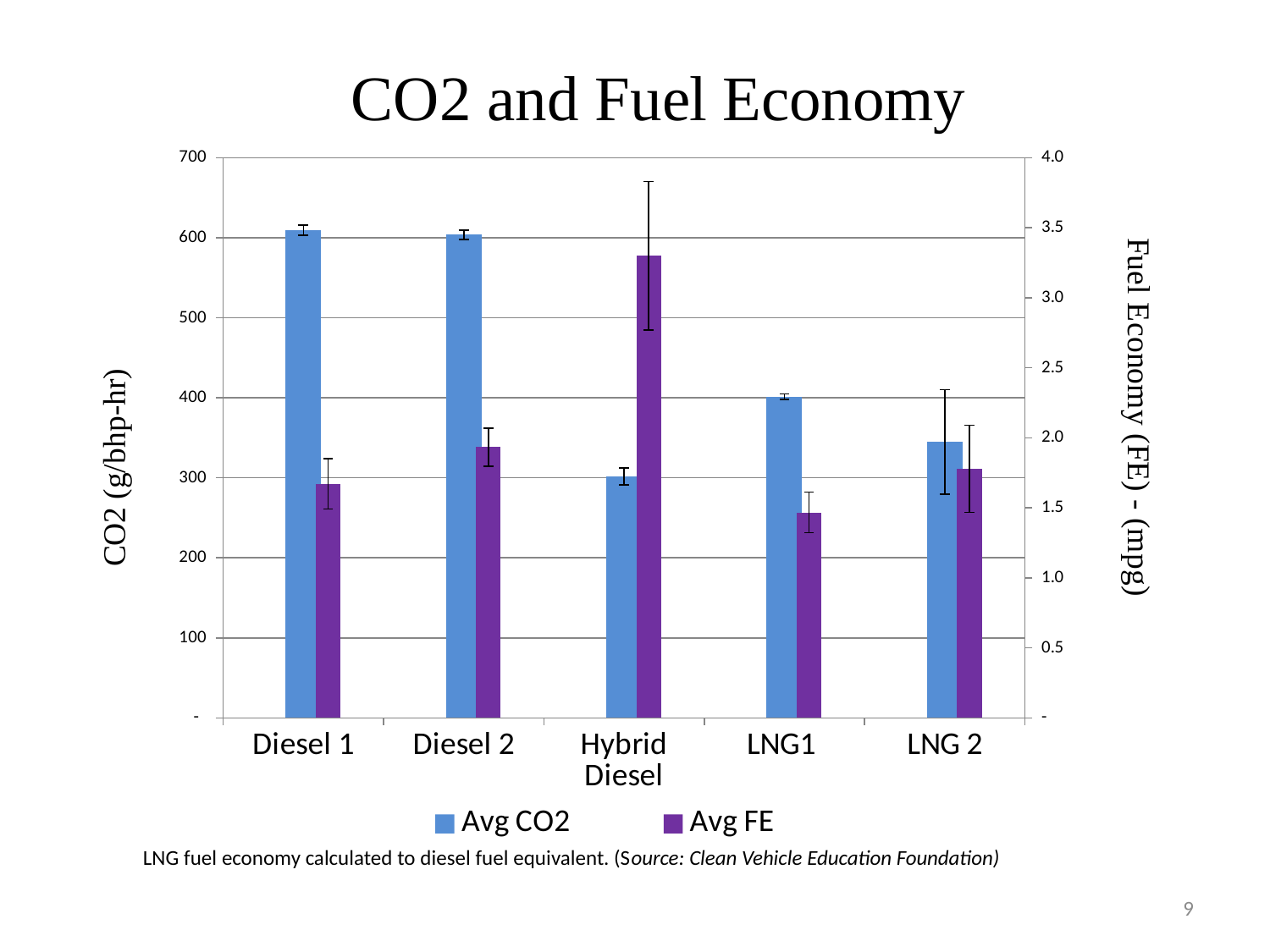
Which category has the lowest Avg CO2 value? Hybrid Diesel Is the Avg FE value for Hybrid Diesel greater or less than 3.0? greater What is the title of the left vertical axis? CO2 (g/bhp-hr) Which category has the highest Avg FE value? Hybrid Diesel Is the Avg CO2 value for Hybrid Diesel greater or less than 400? less What kind of chart is shown on the slide? bar chart How many series does the legend list? 2 Which has the larger Avg FE value, Hybrid Diesel or Diesel 2? Hybrid Diesel Is the Avg FE value for LNG1 greater or less than 2.0? less How many categories are shown on the x axis of the chart? 5 Which has the larger Avg CO2 value, Diesel 1 or LNG1? Diesel 1